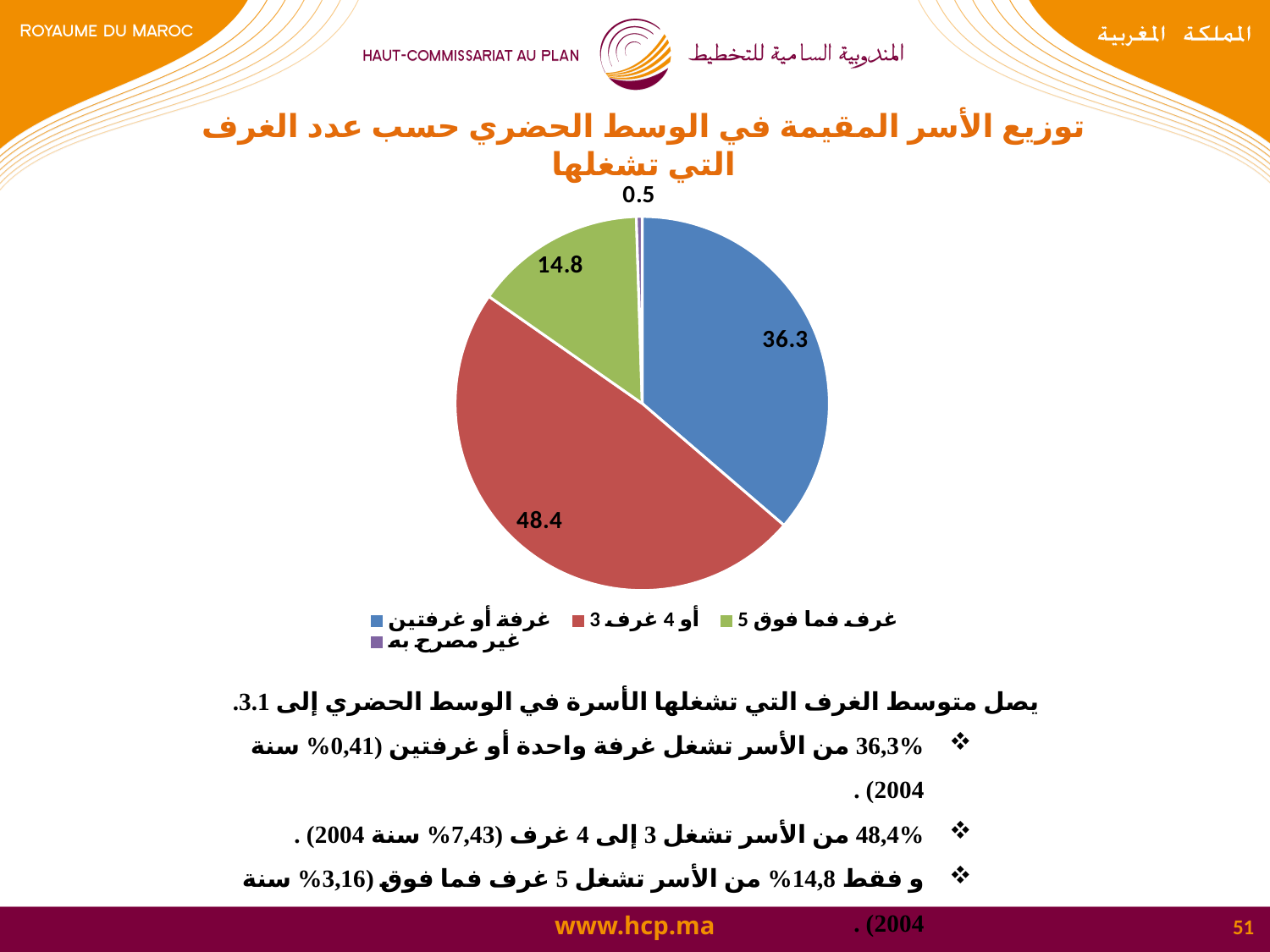
What is the value of the slice for "3 أو 4 غرف" (3 or 4 rooms)? 48.4 How many entries does the legend list? 4 What type of chart is shown on the slide? pie chart Which category has the smallest slice of the pie? غير مصرح به What is the value of the slice for "5 غرف فما فوق" (5 rooms or more)? 14.8 Which category has the largest slice of the pie? 3 أو 4 غرف How many slices does the pie chart have? 4 What colour is the slice for "3 أو 4 غرف"? red What is the difference between the values for "3 أو 4 غرف" and "غرفة أو غرفتين"? 12.1 What is the value of the slice for "غرفة أو غرفتين" (one or two rooms)? 36.3 What is the value of the slice for "غير مصرح به" (not declared)? 0.5 Which is larger: the slice for "غرفة أو غرفتين" or the slice for "5 غرف فما فوق"? غرفة أو غرفتين